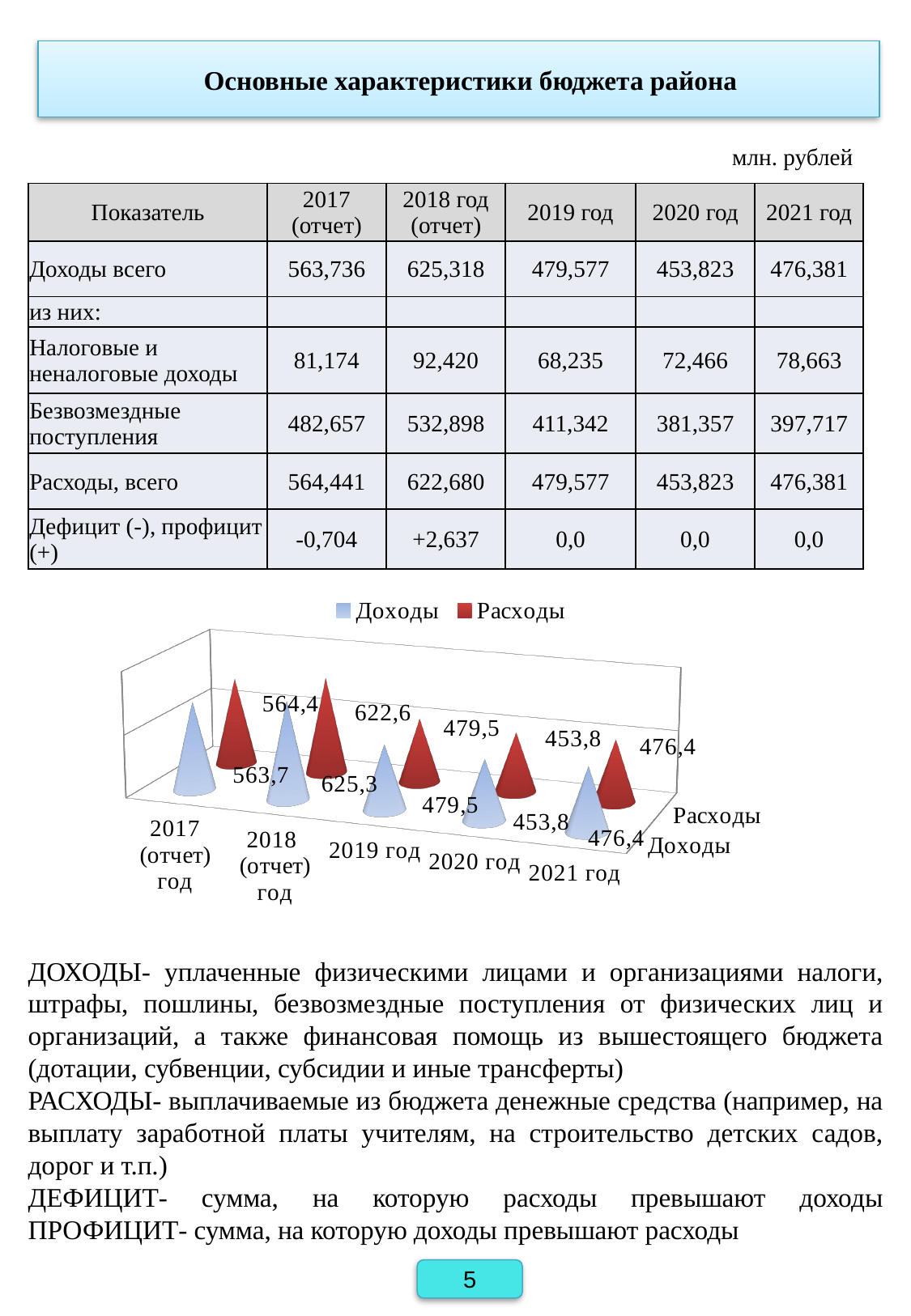
What is the difference between the Доходы values for 2018 (отчет) год and 2019 год in the chart? 145,8 What kind of chart is shown on the slide? 3D bar chart (cone-shaped bars) Do the Доходы values rise or fall from 2018 (отчет) год to 2020 год in the chart? fall In the chart, which is larger for 2017 (отчет) год: Доходы or Расходы? Расходы What is the value of Расходы for 2021 год in the chart? 476,4 What colour represents the Расходы series in the chart? red What is the value of Доходы for 2018 (отчет) год in the chart? 625,3 How many years (categories) are shown on the chart's x axis? 5 Which year has the highest Доходы value in the chart? 2018 (отчет) год What is the value of Расходы for 2017 (отчет) год in the chart? 564,4 Which year has the lowest Расходы value in the chart? 2020 год How many series does the chart legend list? 2